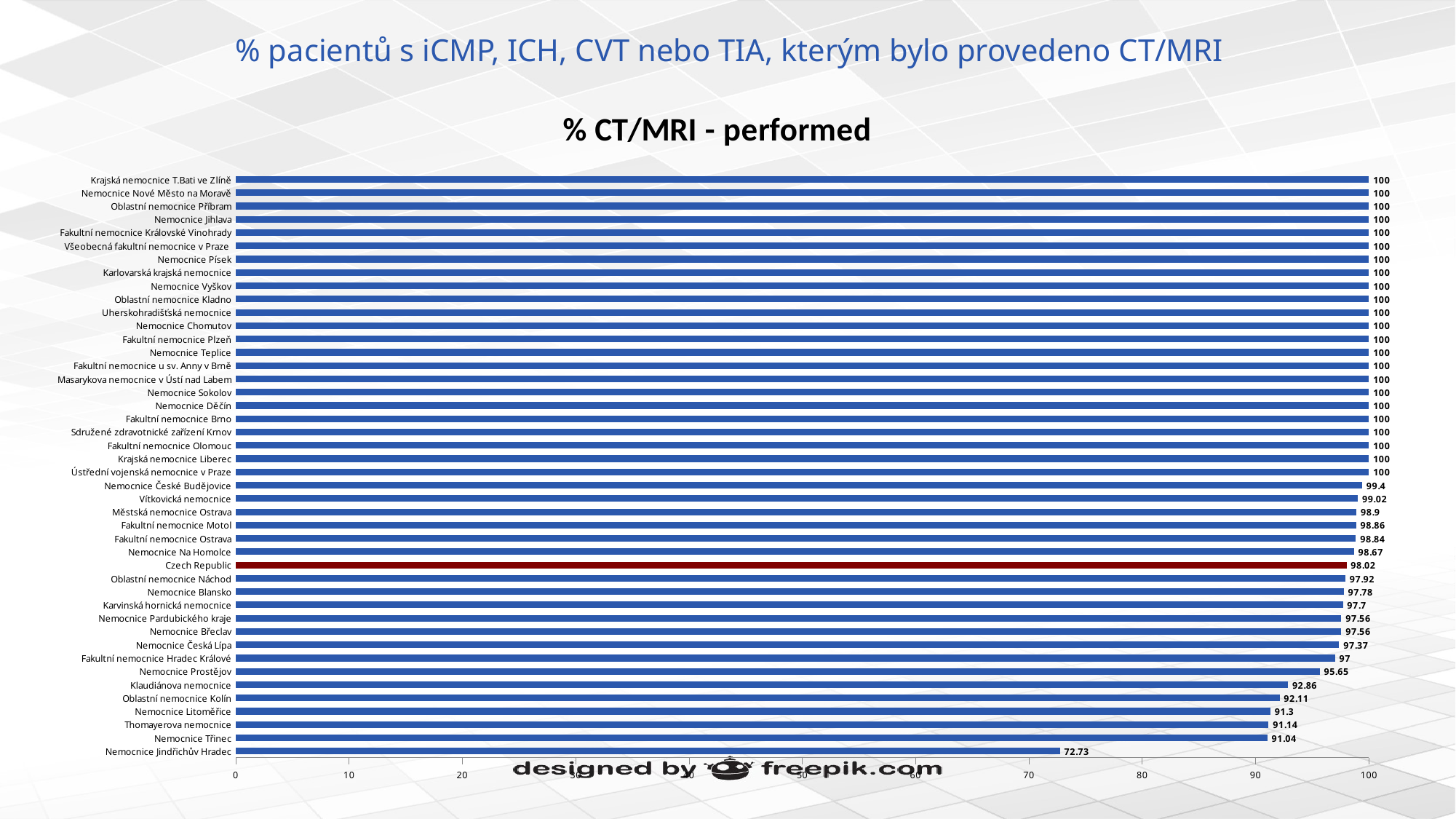
What is the difference between the values for Czech Republic and Nemocnice Jindřichův Hradec? 25.29 What is the value for Czech Republic? 98.02 How many categories have a value of exactly 100? 23 How many hospitals/categories are shown in the chart? 44 Is the value for Nemocnice Jindřichův Hradec greater or less than 80? less Which hospital has the lowest value? Nemocnice Jindřichův Hradec What is the value for Nemocnice Prostějov? 95.65 What is the value for Fakultní nemocnice Motol? 98.86 Which is larger, the value for Klaudiánova nemocnice or the value for Nemocnice Třinec? Klaudiánova nemocnice What is the value for Nemocnice Jindřichův Hradec? 72.73 What is the title of the chart? % CT/MRI - performed What kind of chart is shown on the slide? bar chart